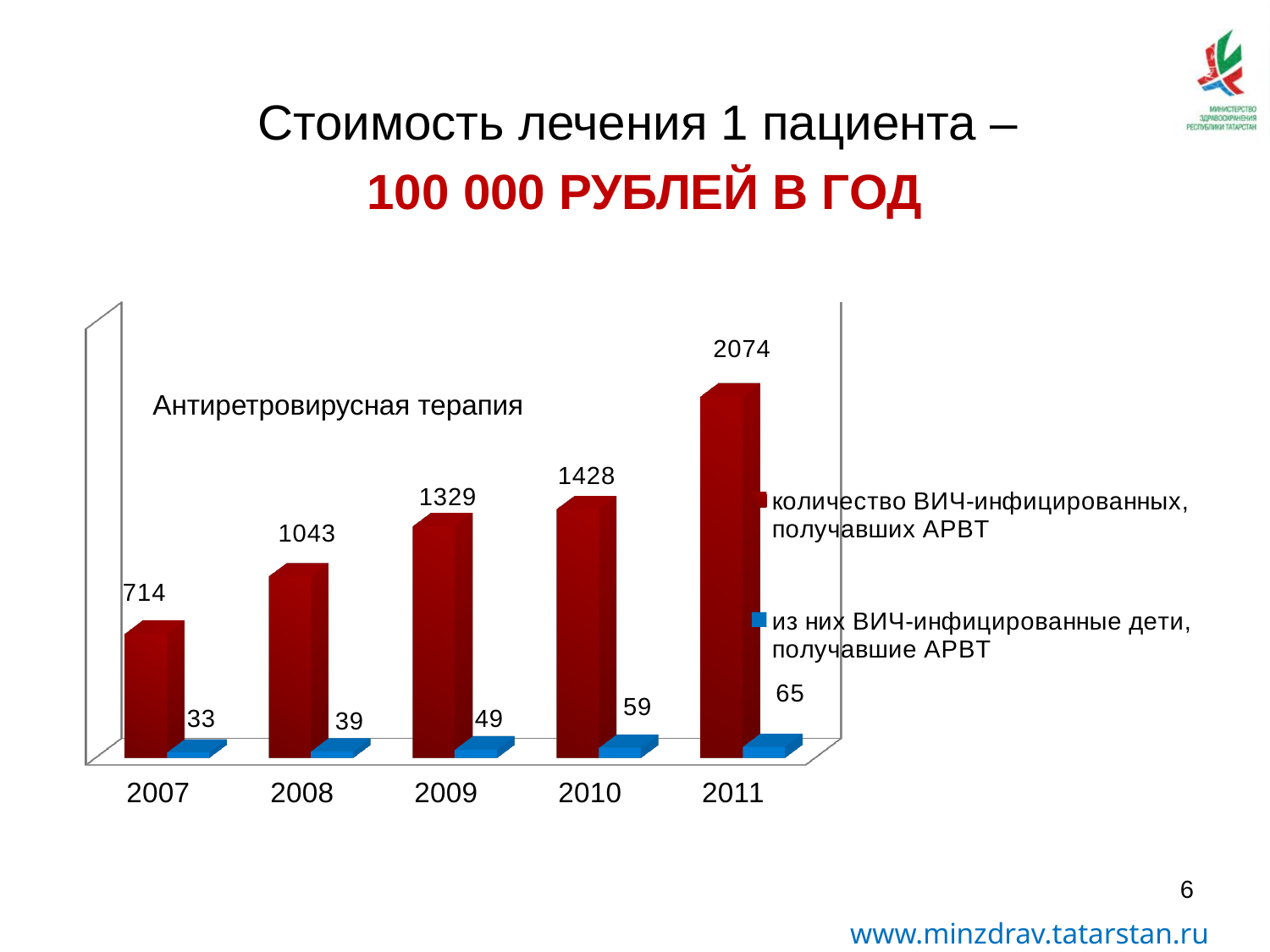
How many years are shown on the x axis? 5 What kind of chart is shown on the slide? bar chart Do the values for 'количество ВИЧ-инфицированных, получавших АРВТ' rise or fall from 2007 to 2011? rise What is the value for 'количество ВИЧ-инфицированных, получавших АРВТ' in 2009? 1329 What is the value for 'из них ВИЧ-инфицированные дети, получавшие АРВТ' in 2010? 59 What is the title shown inside the chart area? Антиретровирусная терапия How many series does the legend list? 2 What is the value for 'количество ВИЧ-инфицированных, получавших АРВТ' in 2007? 714 What is the difference between the 2011 and 2010 values for 'количество ВИЧ-инфицированных, получавших АРВТ'? 646 Which is larger: the 2008 value for 'количество ВИЧ-инфицированных, получавших АРВТ' or the 2009 value? 2009 In which year is the value for 'количество ВИЧ-инфицированных, получавших АРВТ' highest? 2011 In which year is the value for 'из них ВИЧ-инфицированные дети, получавшие АРВТ' lowest? 2007